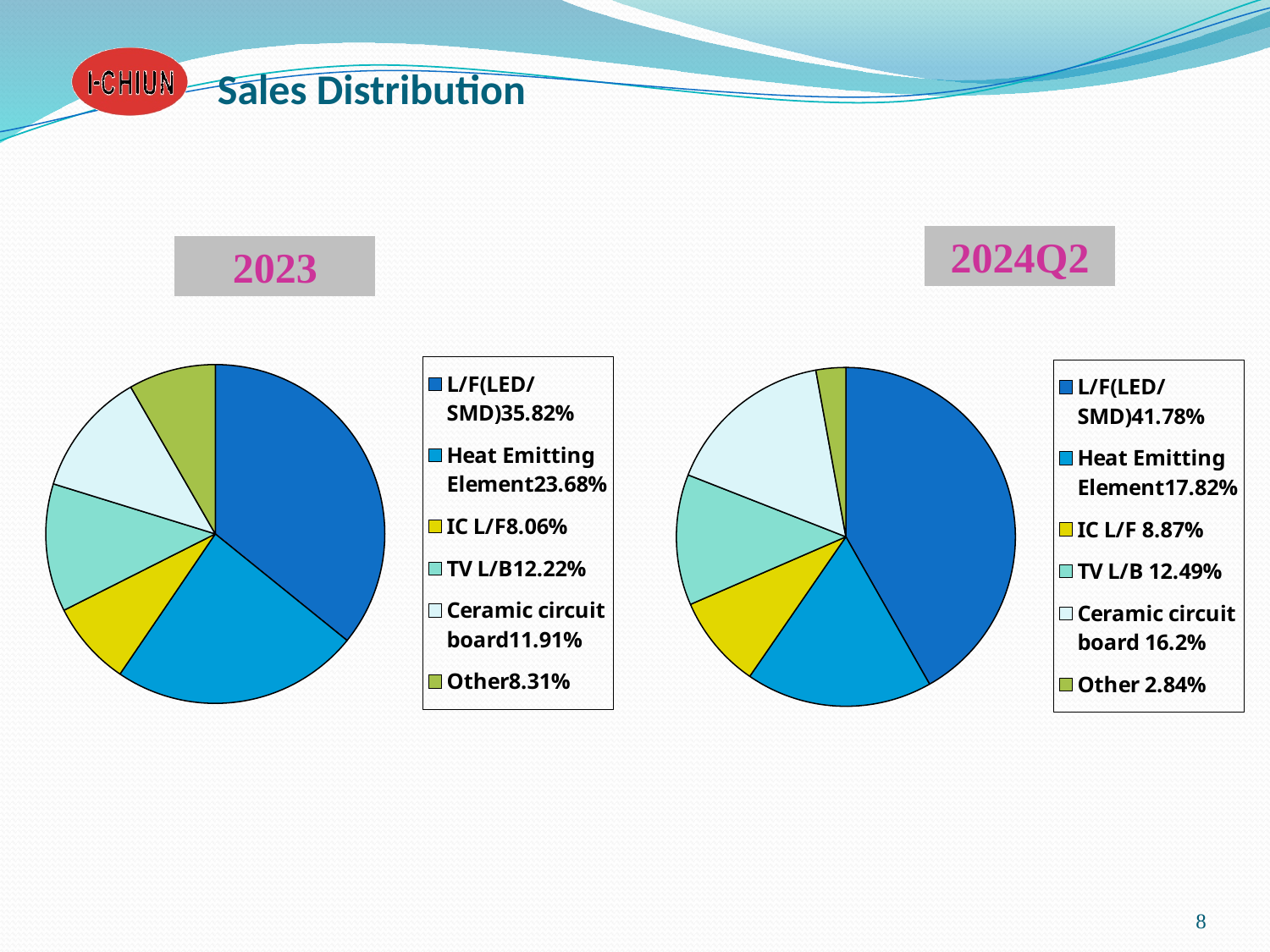
What kind of chart is used for the 2024Q2 sales distribution? Pie chart In the 2023 pie chart, what share does L/F(LED/SMD) have? 35.82% What is the title of the slide containing the two pie charts? Sales Distribution In the 2023 pie chart, what share does Other have? 8.31% In the 2024Q2 pie chart, what share does Heat Emitting Element have? 17.82% In the 2024Q2 pie chart, which is larger: the share of TV L/B or the share of IC L/F? TV L/B In the 2023 pie chart, what is the difference between the shares of Heat Emitting Element and TV L/B? 11.46% How many categories does the 2023 pie chart show? 6 In the 2023 pie chart, which category has the largest share? L/F(LED/SMD) In the 2024Q2 pie chart, which category has the smallest share? Other In the 2023 pie chart, which category has the smallest share? IC L/F